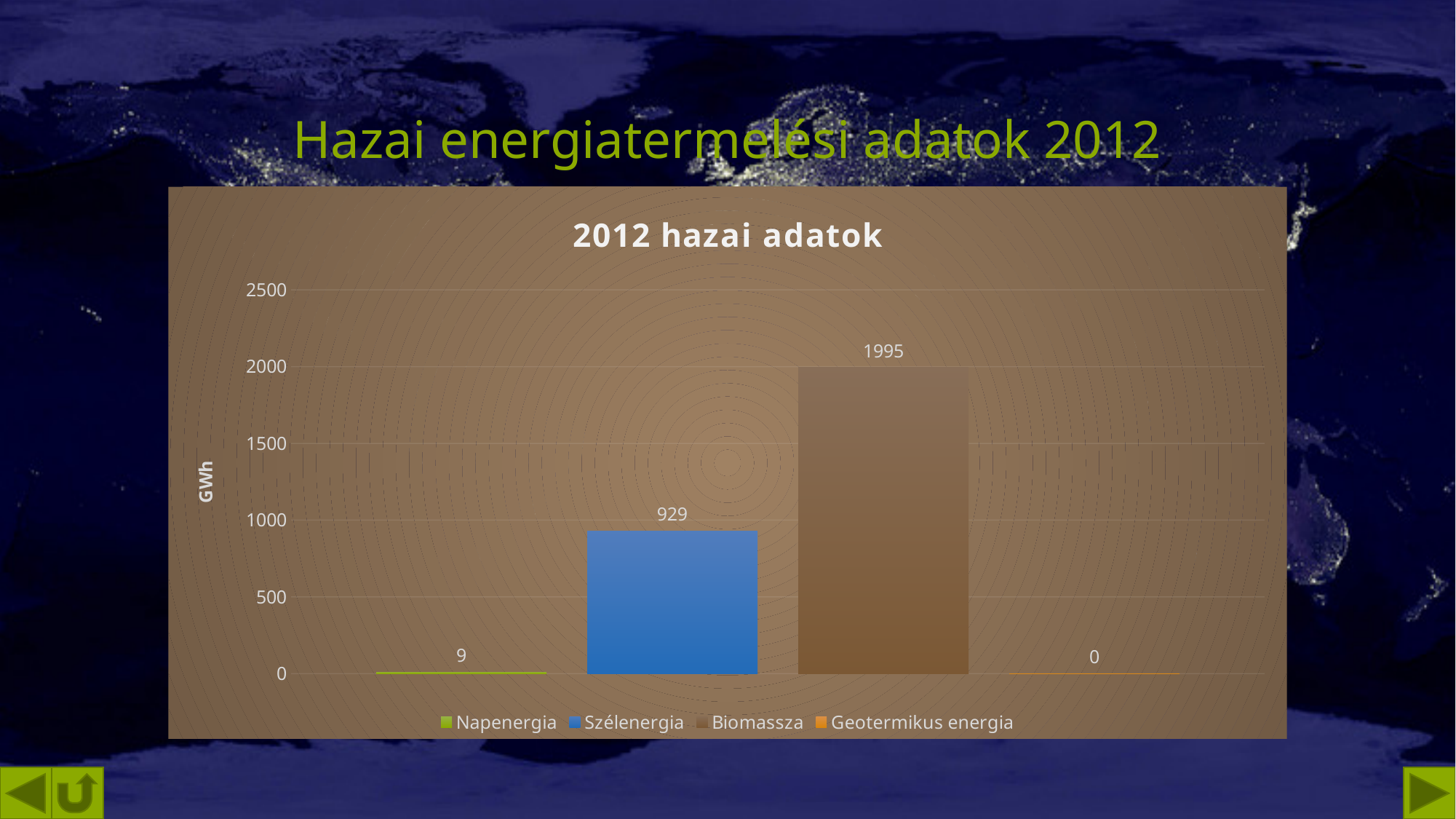
Which category has the highest value? Biomassza Which is larger, the value for Szélenergia or the value for Napenergia? Szélenergia What is the value for Napenergia? 9 Which category has the lowest value? Geotermikus energia What is the value for Geotermikus energia? 0 What is the value for Biomassza? 1995 What kind of chart is shown? bar chart What is the difference between the values for Biomassza and Szélenergia? 1066 What is the title of the chart? 2012 hazai adatok What is the value for Szélenergia? 929 Is the value for Szélenergia greater or less than 1000? less How many entries does the legend list? 4